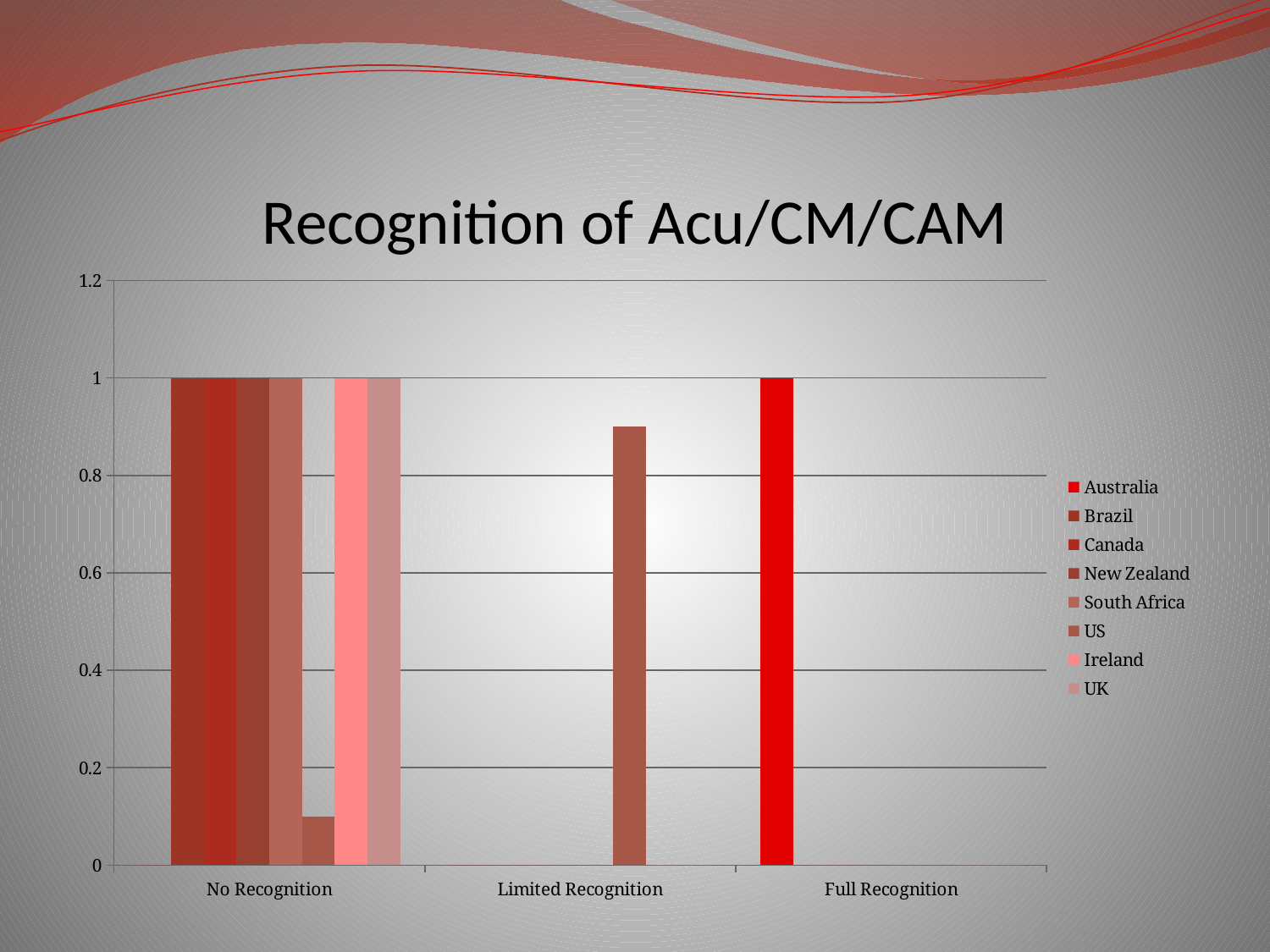
What is the value for Australia in the Full Recognition category? 1 What is the value for Brazil in the No Recognition category? 1 Is the value for US in the No Recognition category greater or less than 0.2? less Is the value for US in the Limited Recognition category greater or less than 0.8? greater Which is larger for US: the value in Limited Recognition or the value in No Recognition? Limited Recognition What kind of chart is shown on the slide? bar chart How many categories are shown on the x axis? 3 What is the title of the chart? Recognition of Acu/CM/CAM Which is larger: Australia in Full Recognition or US in Limited Recognition? Australia in Full Recognition How many series does the legend list? 8 Which series has the only visible bar in the Limited Recognition category? US Which series is shown in bright red in the legend? Australia